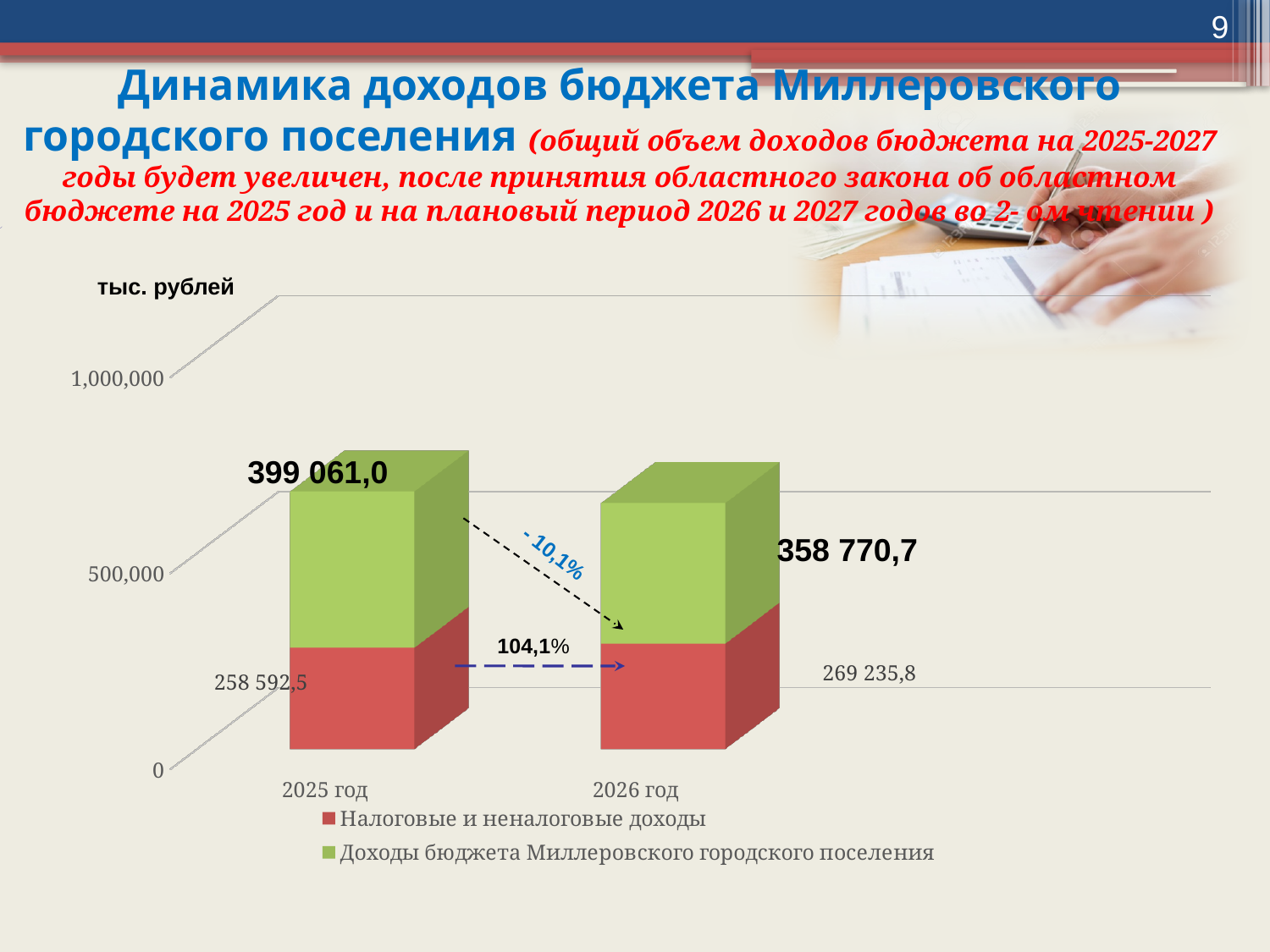
By how much does 'Доходы бюджета Миллеровского городского поселения' decrease from 2025 год to 2026 год? 40 290,3 What is the value of 'Доходы бюджета Миллеровского городского поселения' for 2026 год? 358 770,7 Which year has the larger value for 'Налоговые и неналоговые доходы', 2025 год or 2026 год? 2026 год How many categories (years) are shown on the x axis of the chart? 2 What unit of measurement is indicated above the chart's vertical axis? тыс. рублей What is the value of 'Доходы бюджета Миллеровского городского поселения' for 2025 год? 399 061,0 What is the value of 'Налоговые и неналоговые доходы' for 2025 год? 258 592,5 How many series does the chart legend list? 2 What percentage change is shown by the dashed arrow between the green segments of the two bars? - 10,1% What type of chart is shown on the slide? Stacked bar chart By how much does 'Налоговые и неналоговые доходы' increase from 2025 год to 2026 год? 10 643,3 What is the value of 'Налоговые и неналоговые доходы' for 2026 год? 269 235,8